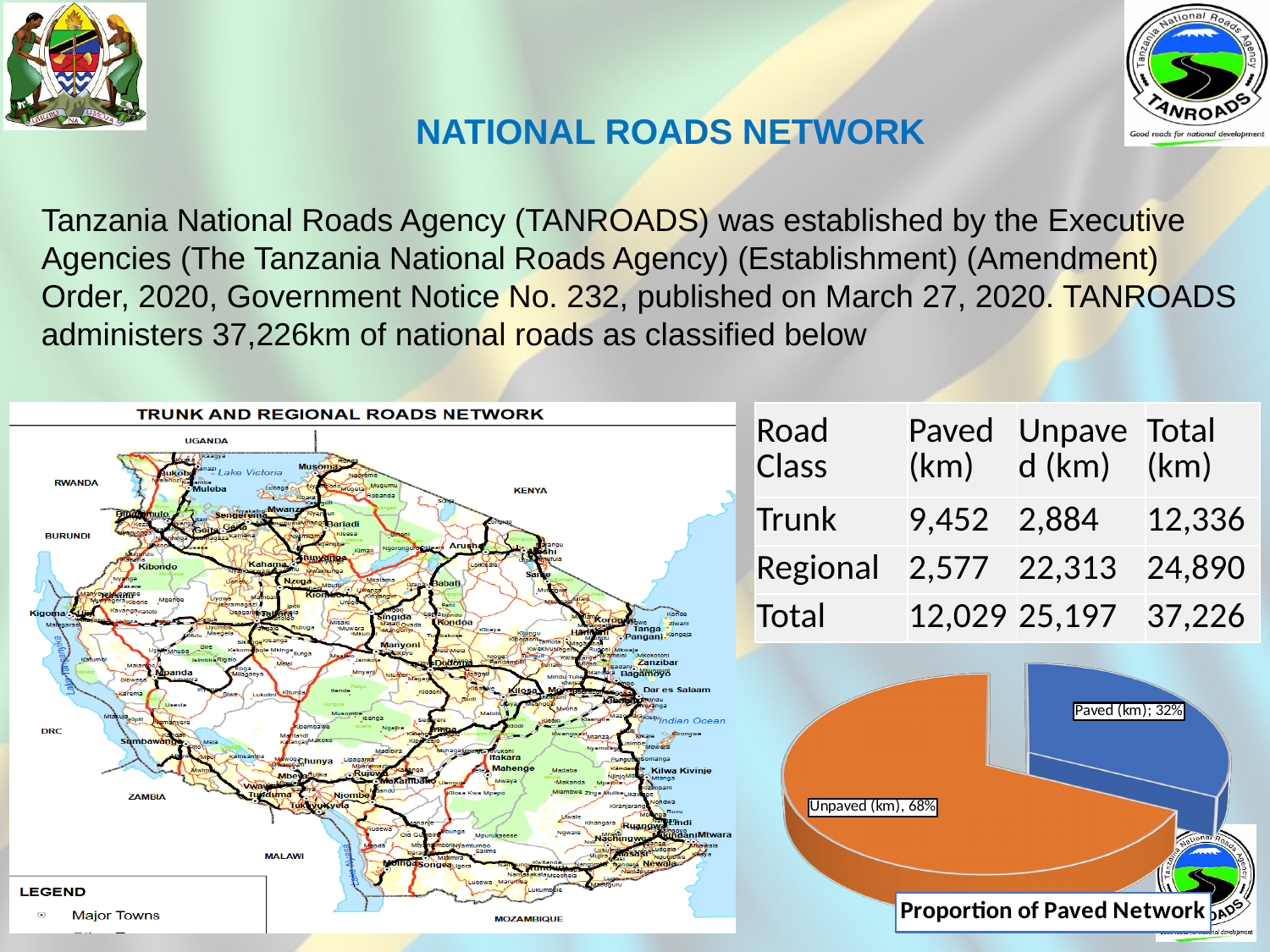
What share of the pie chart does the Unpaved (km) slice represent? 68% What is the title of the pie chart? Proportion of Paved Network Which slice of the pie chart is the largest? Unpaved (km) By how many percentage points does the Unpaved (km) share exceed the Paved (km) share in the pie chart? 36 Is the Paved (km) slice or the Unpaved (km) slice larger in the pie chart? Unpaved (km) What share of the pie chart does the Paved (km) slice represent? 32% What colour is the Unpaved (km) slice in the pie chart? Orange Which slice of the pie chart is the smallest? Paved (km) How many slices does the pie chart have? 2 Is the Paved (km) share in the pie chart greater or less than 50%? less What type of chart is shown at the bottom right of the slide? Pie chart